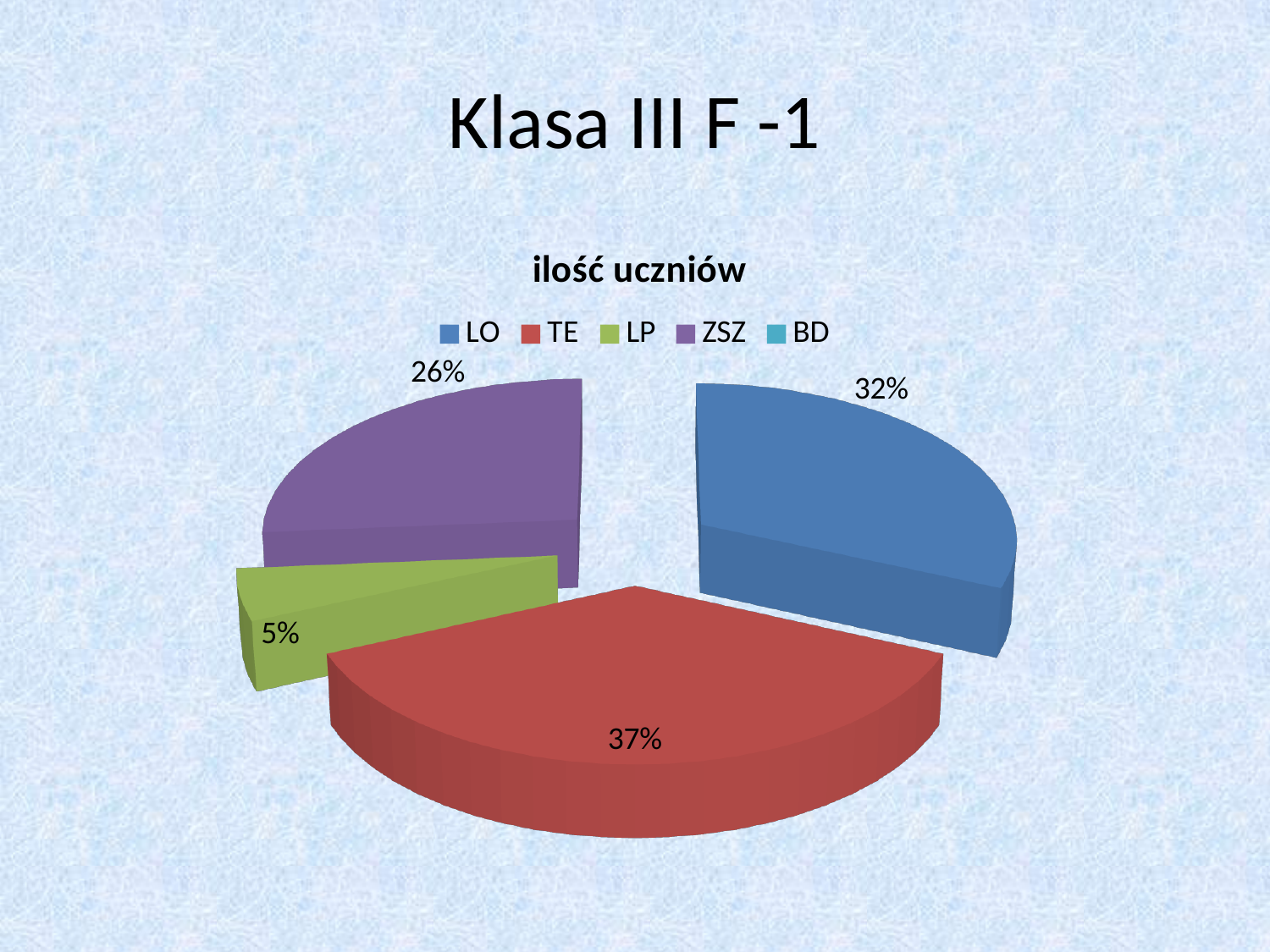
What share of the pie does the TE slice represent? 37% What percentage is labelled on the LP slice? 5% Which category has the largest slice of the pie? TE What is the value shown for the LO slice? 32% Which slice is larger, ZSZ or LO? LO What percentage is labelled on the ZSZ slice? 26% How many categories does the legend list? 5 By how many percentage points does the TE slice exceed the LO slice? 5 Which of the slices shown in the pie is the smallest? LP How many slices with percentage labels are visible in the pie? 4 What kind of chart is shown on the slide? Pie chart What is the title of the chart? ilość uczniów